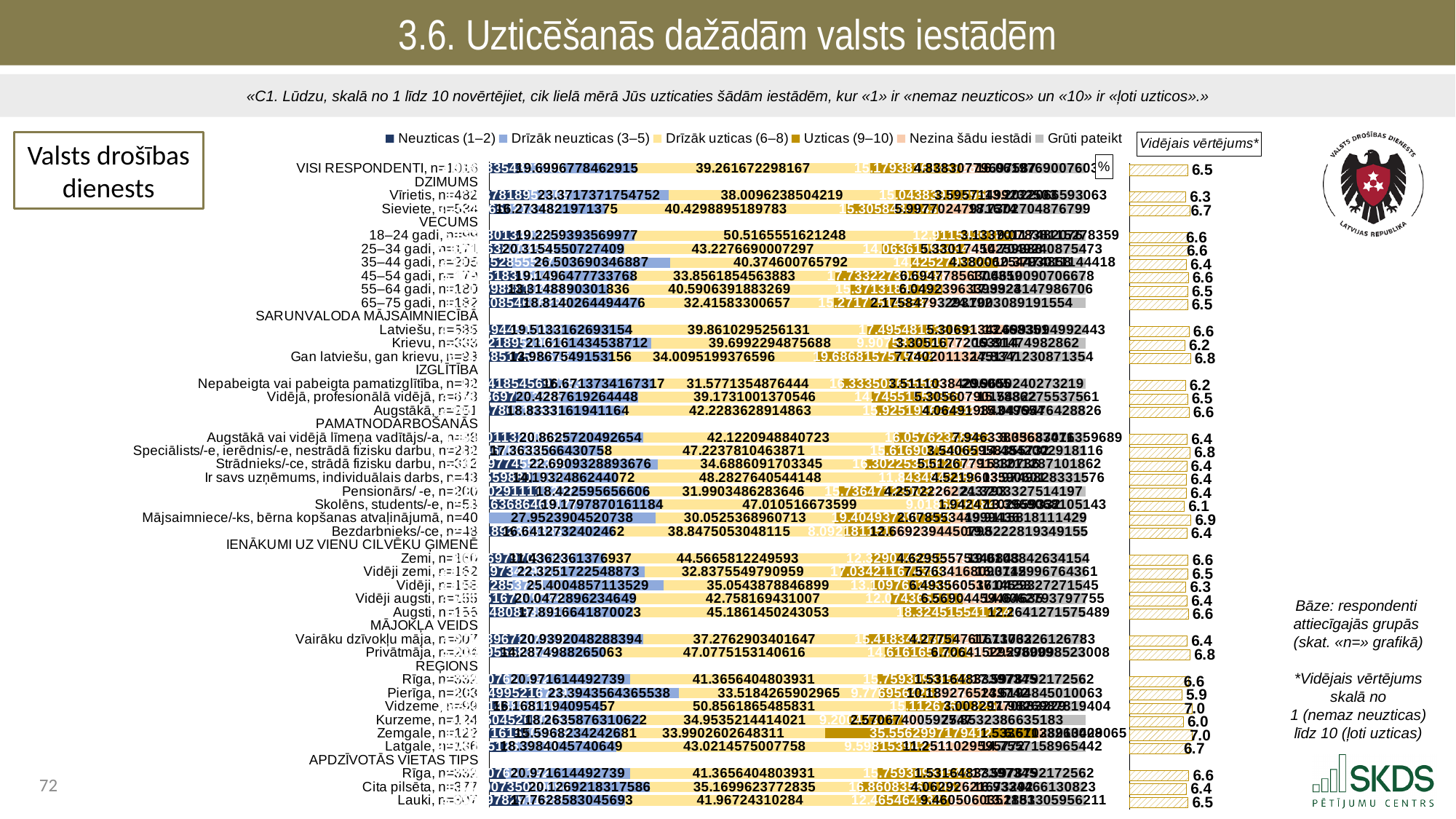
What is the average rating shown for Pierīga? 5.9 Among the PAMATNODARBOŠANĀS groups, which has the highest average rating? Mājsaimniece/-ks, bērna kopšanas atvaļinājumā What is the difference between the average ratings of Sieviete and Vīrietis? 0.4 What is the average rating shown for Vidzeme? 7.0 Which has a higher average rating, Latviešu or Krievu? Latviešu What kind of chart is shown on the slide? Stacked horizontal bar chart What is the average rating for Skolēns, students? 6.1 What is the average rating (Vidējais vērtējums) for VISI RESPONDENTI? 6.5 How many series does the legend list? 6 What is the first legend entry of the chart? Neuzticas (1–2) What is the average rating for Sieviete? 6.7 Among the REĢIONS groups, which has the lowest average rating? Pierīga